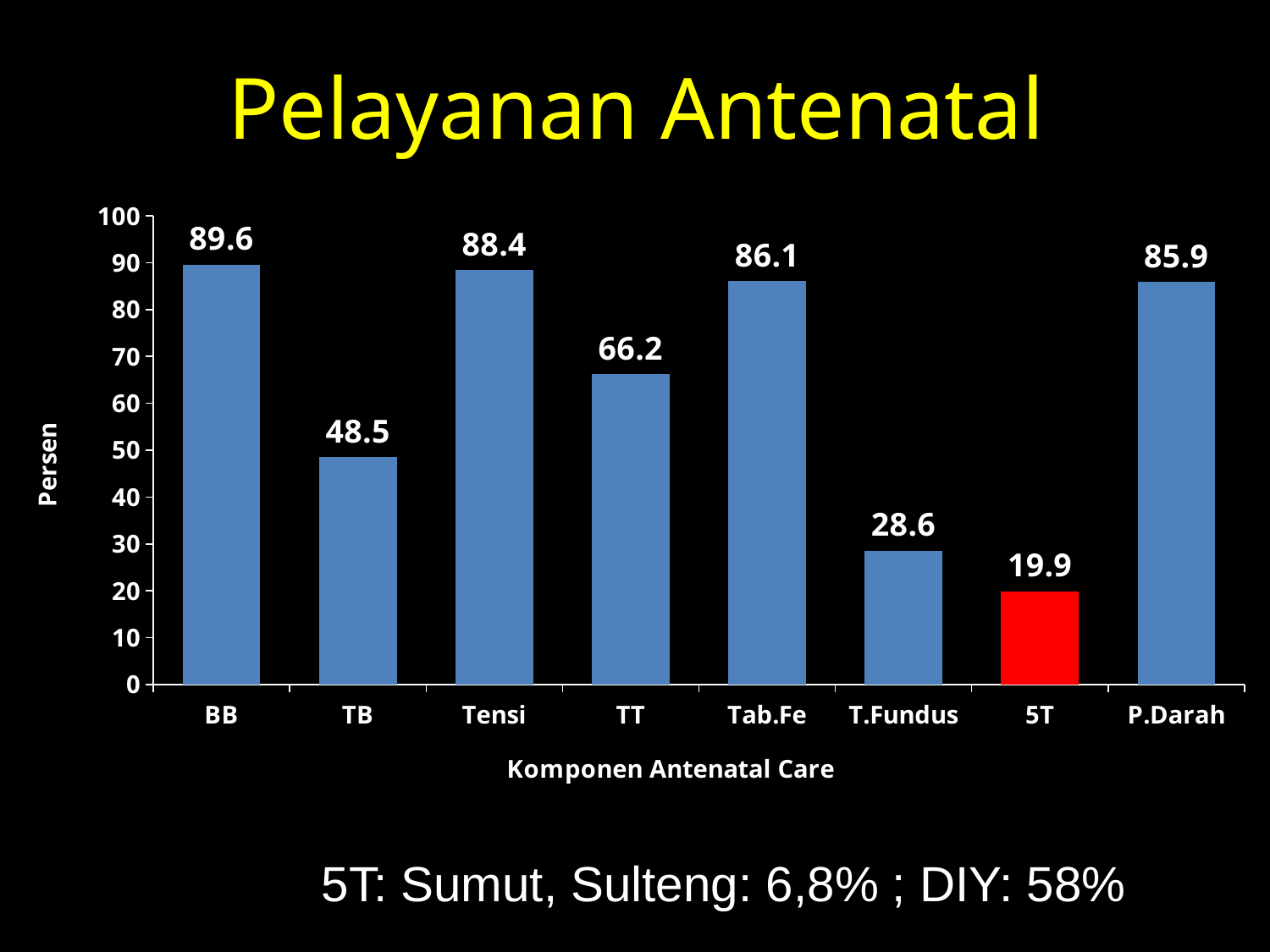
How many categories are shown on the x axis? 8 Is the value for Tab.Fe greater or less than 80? greater Which bar is coloured red instead of blue? 5T What is the value for T.Fundus? 28.6 What is the value for 5T? 19.9 Which category has the highest value? BB What is the difference between the values for TT and T.Fundus? 37.6 What is the difference between the values for BB and TB? 41.1 Which category has the lowest value? 5T What is the value for BB? 89.6 What kind of chart is shown on the slide? bar chart Which is larger, the value for Tensi or the value for TT? Tensi